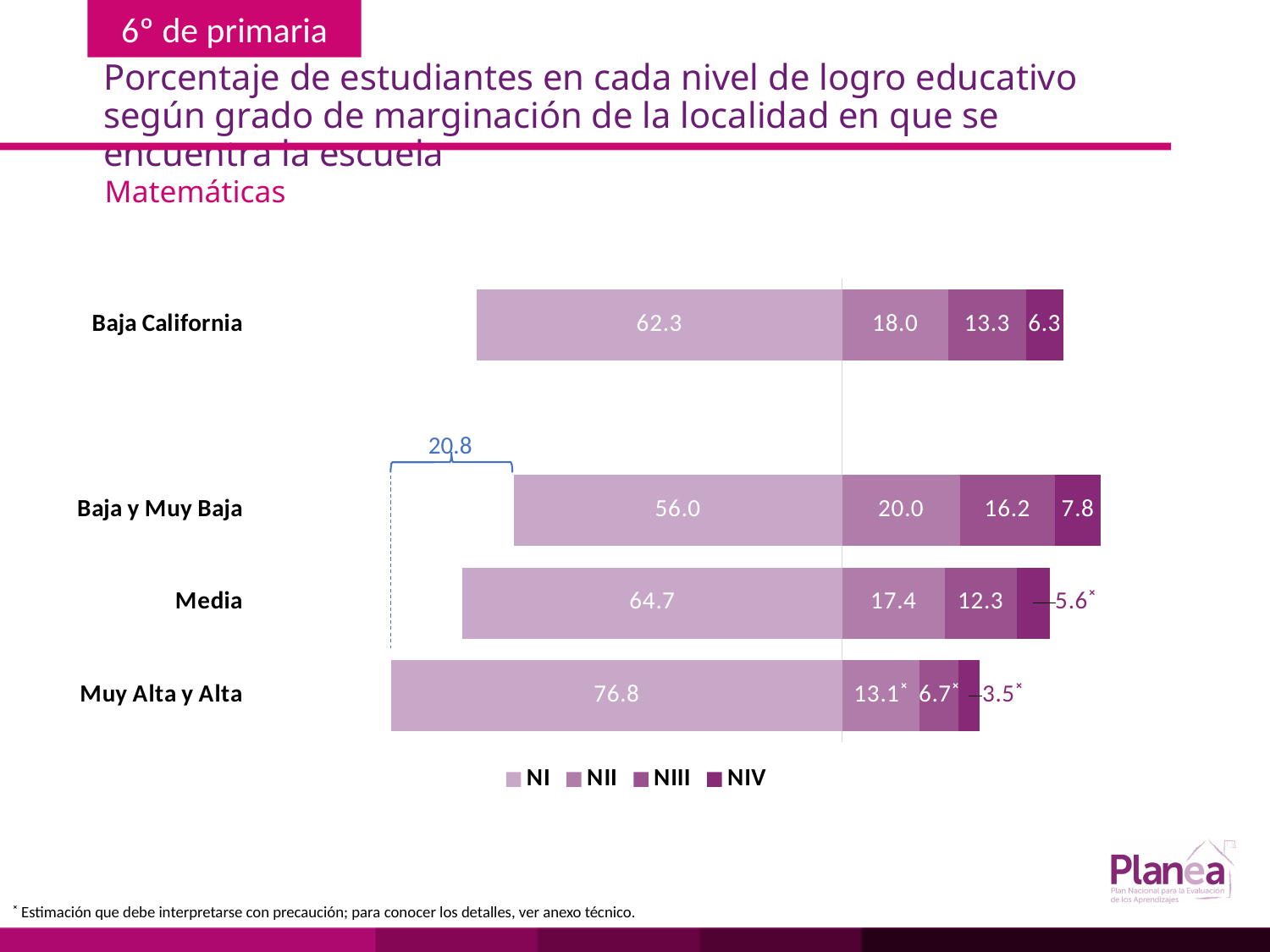
What is the difference between the NI values for Muy Alta y Alta and Baja y Muy Baja? 20.8 What is the NIII value for Baja California? 13.3 What is the NI value for Muy Alta y Alta? 76.8 Which category has the lowest NIV value? Muy Alta y Alta Which is larger, the NII value for Baja California or the NII value for Media? Baja California What is the total of the stacked bar for Baja y Muy Baja? 100.0 Which category has the highest NI value? Muy Alta y Alta How many series does the legend list? 4 What is the NII value for Baja y Muy Baja? 20.0 How many categories are shown on the chart? 4 What is the NIV value for Media? 5.6 What kind of chart is shown on the slide? Stacked bar chart